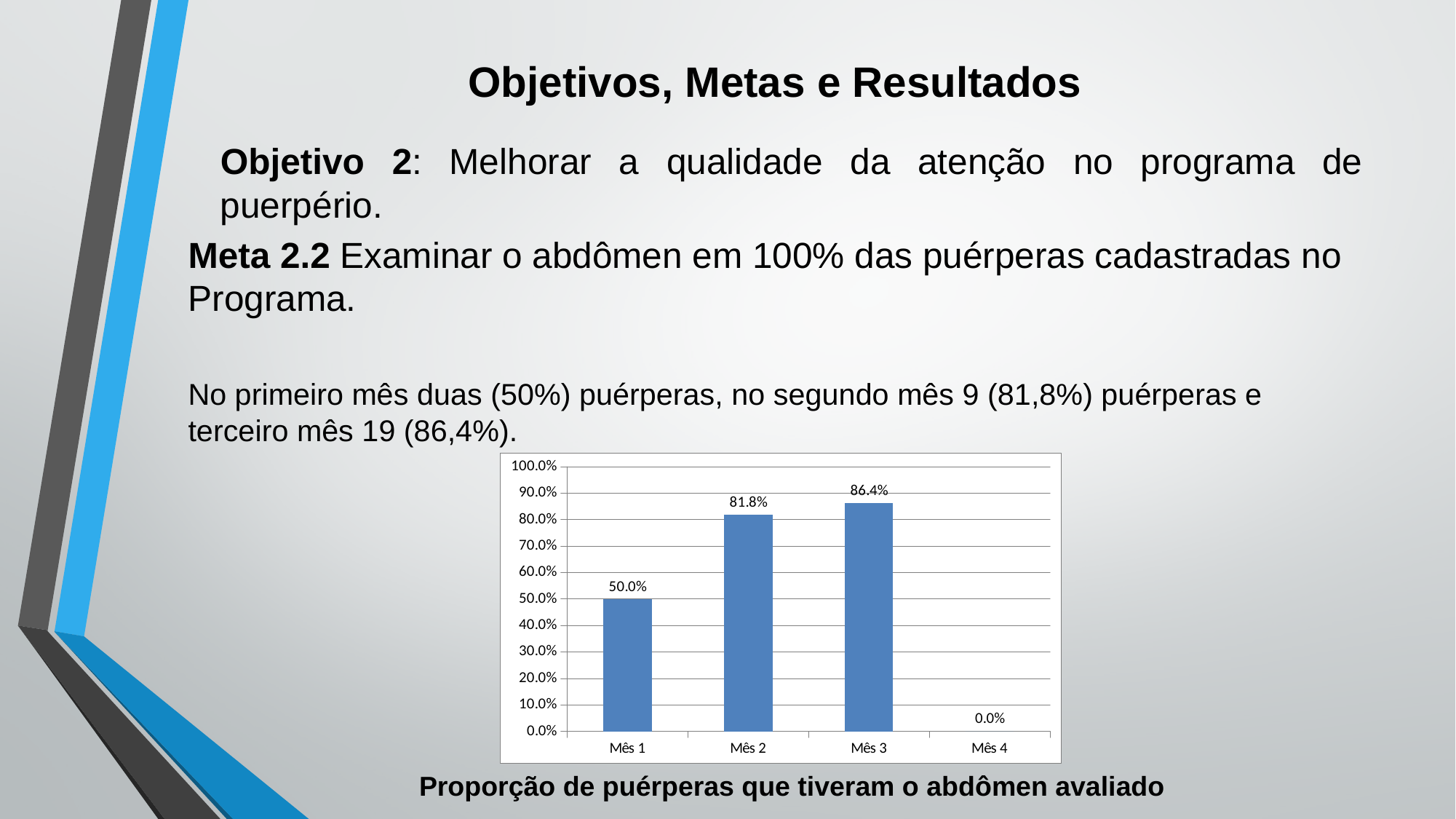
What is the difference between the values for Mês 2 and Mês 1? 31.8% What kind of chart is shown on the slide? Bar chart What is the value for Mês 4? 0.0% How many months are shown on the x axis of the chart? 4 Which month has the lowest value? Mês 4 What is the value for Mês 1? 50.0% What is the difference between the values for Mês 3 and Mês 2? 4.6% Which month has the highest value? Mês 3 What is the caption below the chart? Proporção de puérperas que tiveram o abdômen avaliado Which is larger, the value for Mês 1 or the value for Mês 2? Mês 2 What is the value for Mês 2? 81.8% What is the value for Mês 3? 86.4%